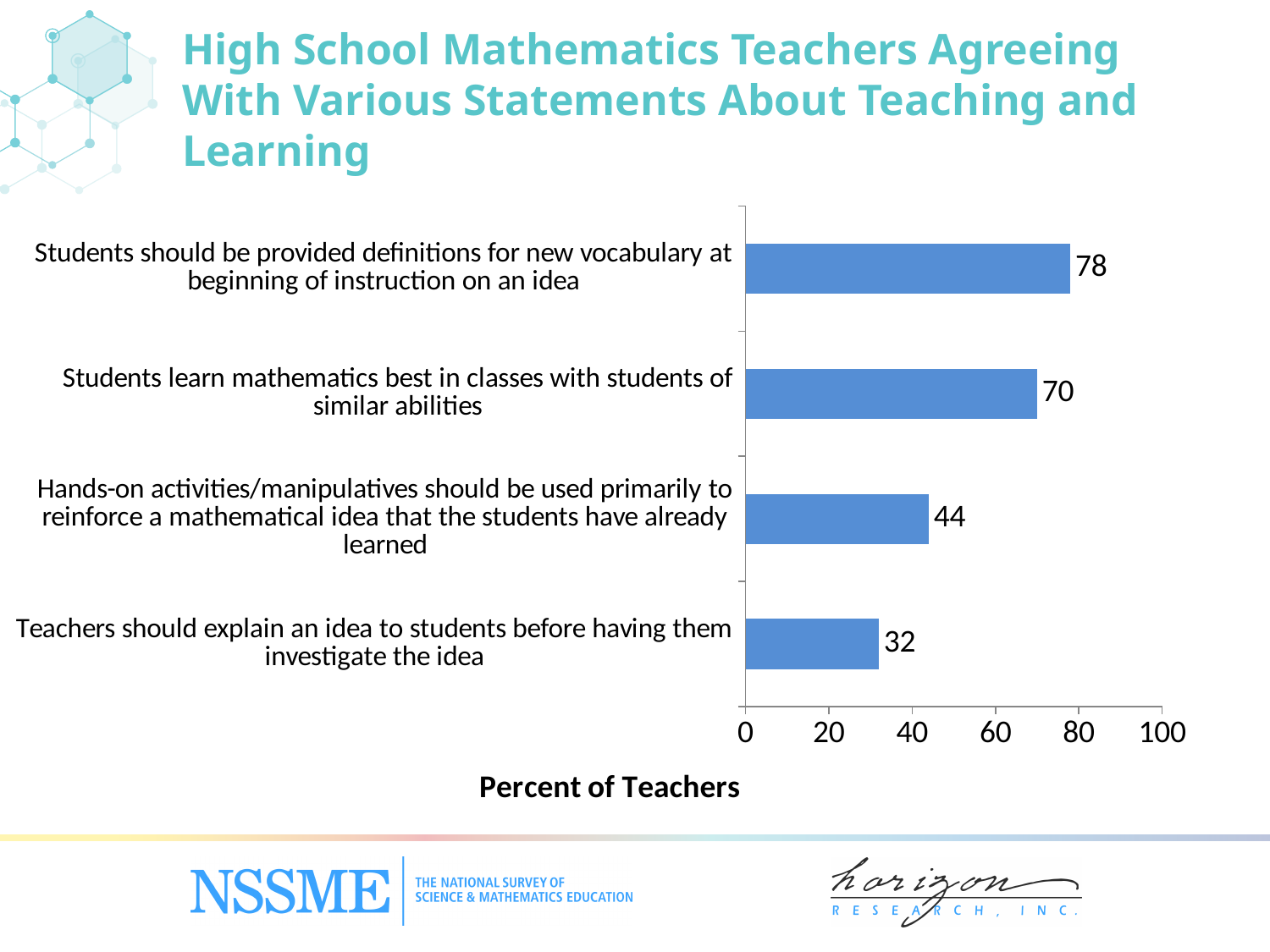
Which statement has the lowest percent of teachers agreeing? Teachers should explain an idea to students before having them investigate the idea Which has a higher percent of teachers agreeing: the statement about students learning best in classes with similar abilities, or the statement about hands-on activities reinforcing already-learned ideas? Students learn mathematics best in classes with students of similar abilities Which statement has the highest percent of teachers agreeing? Students should be provided definitions for new vocabulary at beginning of instruction on an idea Is the percent of teachers agreeing that hands-on activities should be used primarily to reinforce already-learned ideas greater or less than 60? less How many statements are shown in the chart? 4 What kind of chart is shown on the slide? bar chart What percent of teachers agree that hands-on activities/manipulatives should be used primarily to reinforce a mathematical idea that the students have already learned? 44 What is the label of the horizontal axis? Percent of Teachers What percent of teachers agree that students learn mathematics best in classes with students of similar abilities? 70 What is the difference in percent of teachers between the statement about providing definitions for new vocabulary and the statement about explaining an idea before students investigate it? 46 What percent of teachers agree that students should be provided definitions for new vocabulary at the beginning of instruction on an idea? 78 What percent of teachers agree that teachers should explain an idea to students before having them investigate the idea? 32